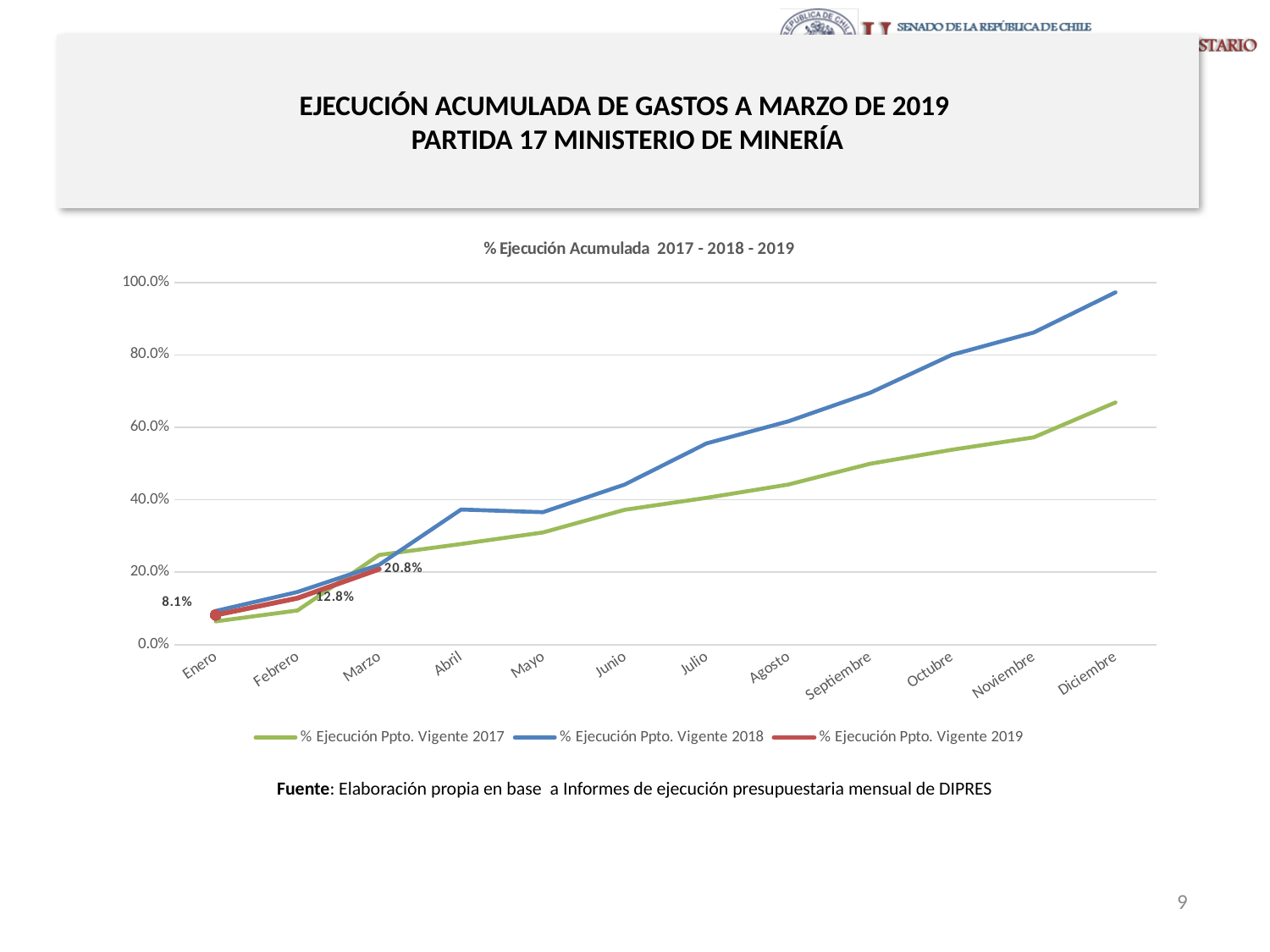
What is the value for Enero in the % Ejecución Ppto. Vigente 2019 series? 8.1% What is the title of the chart? % Ejecución Acumulada 2017 - 2018 - 2019 What is the value for Febrero in the % Ejecución Ppto. Vigente 2019 series? 12.8% How many series does the chart legend list? 3 In Diciembre, which series is higher: % Ejecución Ppto. Vigente 2017 or % Ejecución Ppto. Vigente 2018? % Ejecución Ppto. Vigente 2018 What is the value for Marzo in the % Ejecución Ppto. Vigente 2019 series? 20.8% Does the % Ejecución Ppto. Vigente 2018 series rise or fall from Enero to Diciembre? Rise What kind of chart is shown on the slide? Line chart By how much did the % Ejecución Ppto. Vigente 2019 series increase from Enero to Marzo? 12.7% Is the Diciembre value for % Ejecución Ppto. Vigente 2018 greater or less than 80.0%? greater What is the difference between the Febrero and Enero values of the % Ejecución Ppto. Vigente 2019 series? 4.7% How many months are shown on the x axis of the chart? 12